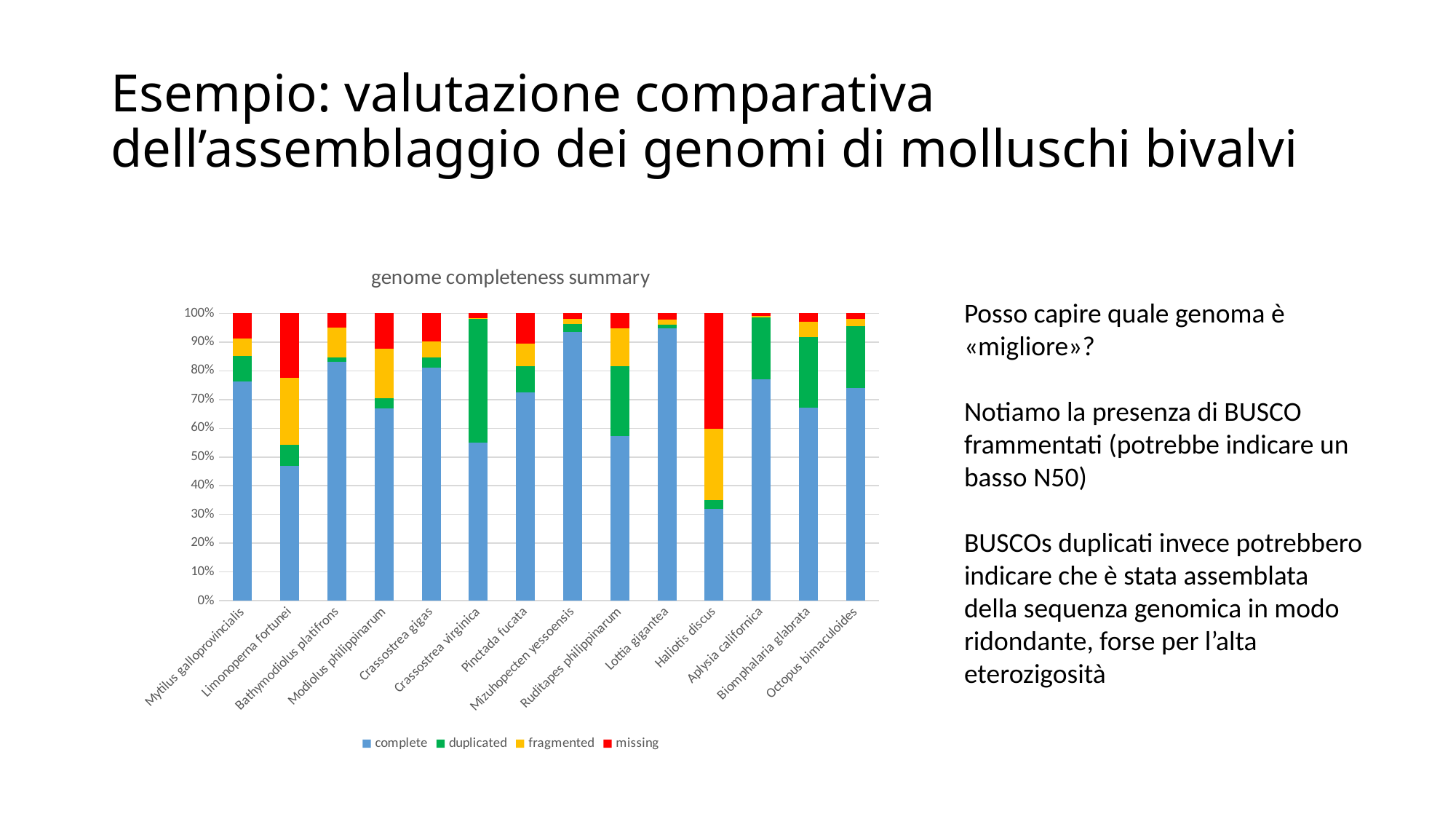
What does each stacked bar total on the y axis? 100% Which species has the largest 'missing' share? Haliotis discus Is the 'complete' value for Haliotis discus greater or less than 40%? less What is the title of the chart? genome completeness summary How many species (categories) are plotted on the x axis? 14 Which species has the largest 'duplicated' share? Crassostrea virginica Which has a larger 'complete' share, Mytilus galloprovincialis or Limnoperna fortunei? Mytilus galloprovincialis What kind of chart is shown on the slide? Stacked bar chart Which species has the lowest 'complete' share? Haliotis discus Which series is shown in red in the chart? missing How many series does the chart legend list? 4 Is the 'complete' value for Mytilus galloprovincialis greater or less than 70%? greater